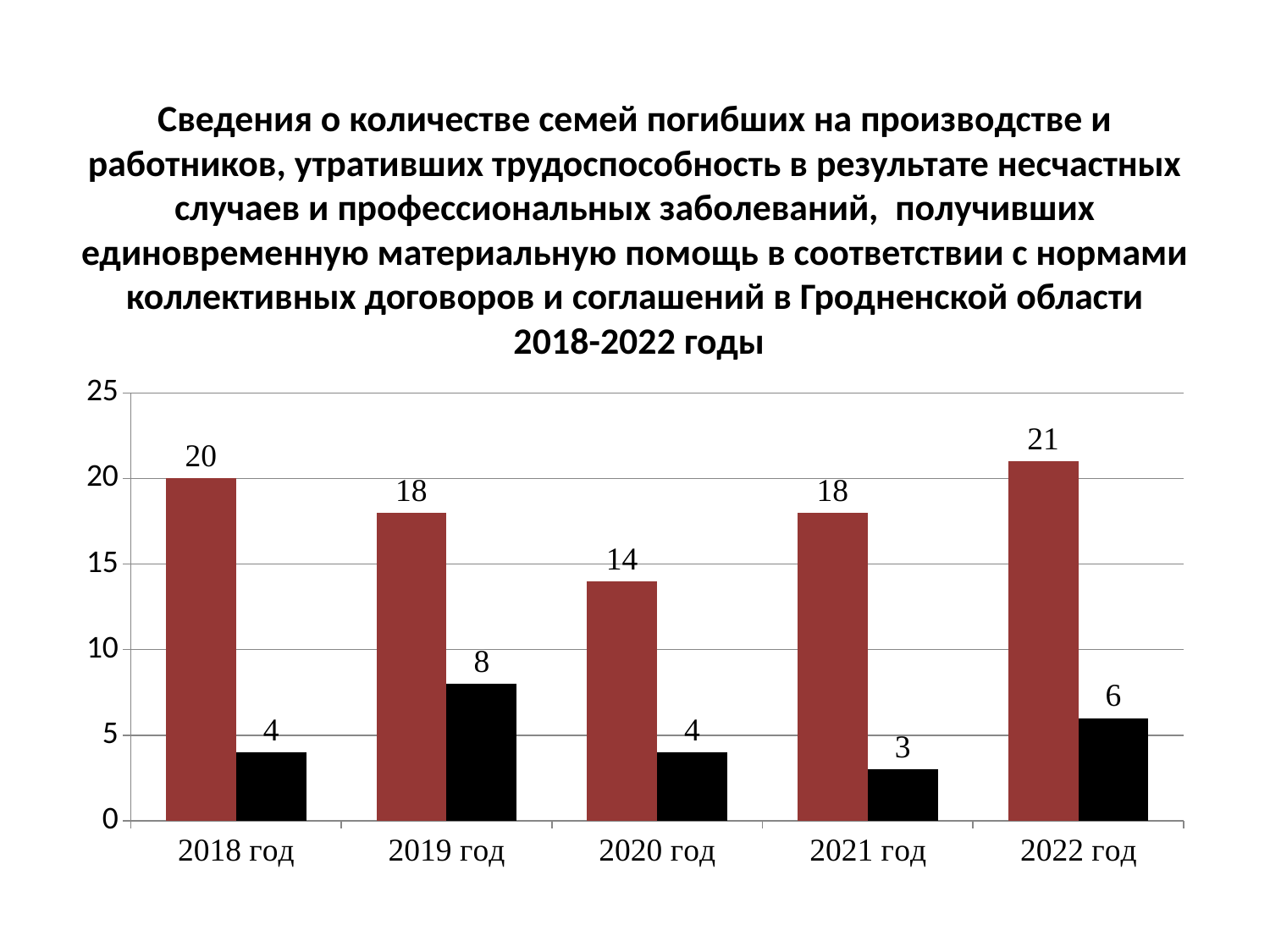
What colours are the two series of bars in the chart? Red and black What is the value of the red bar for 2020 год? 14 What is the value of the red bar for 2018 год? 20 What is the value of the black bar for 2019 год? 8 In which year is the black bar lowest? 2021 год Which is larger: the black bar for 2019 год or the black bar for 2022 год? 2019 год What kind of chart is shown on the slide? Bar chart Does the red bar rise or fall from 2021 год to 2022 год? Rise In which year is the red bar highest? 2022 год What is the difference between the red bar and the black bar for 2022 год? 15 How many years are shown on the x axis? 5 What is the value of the black bar for 2021 год? 3